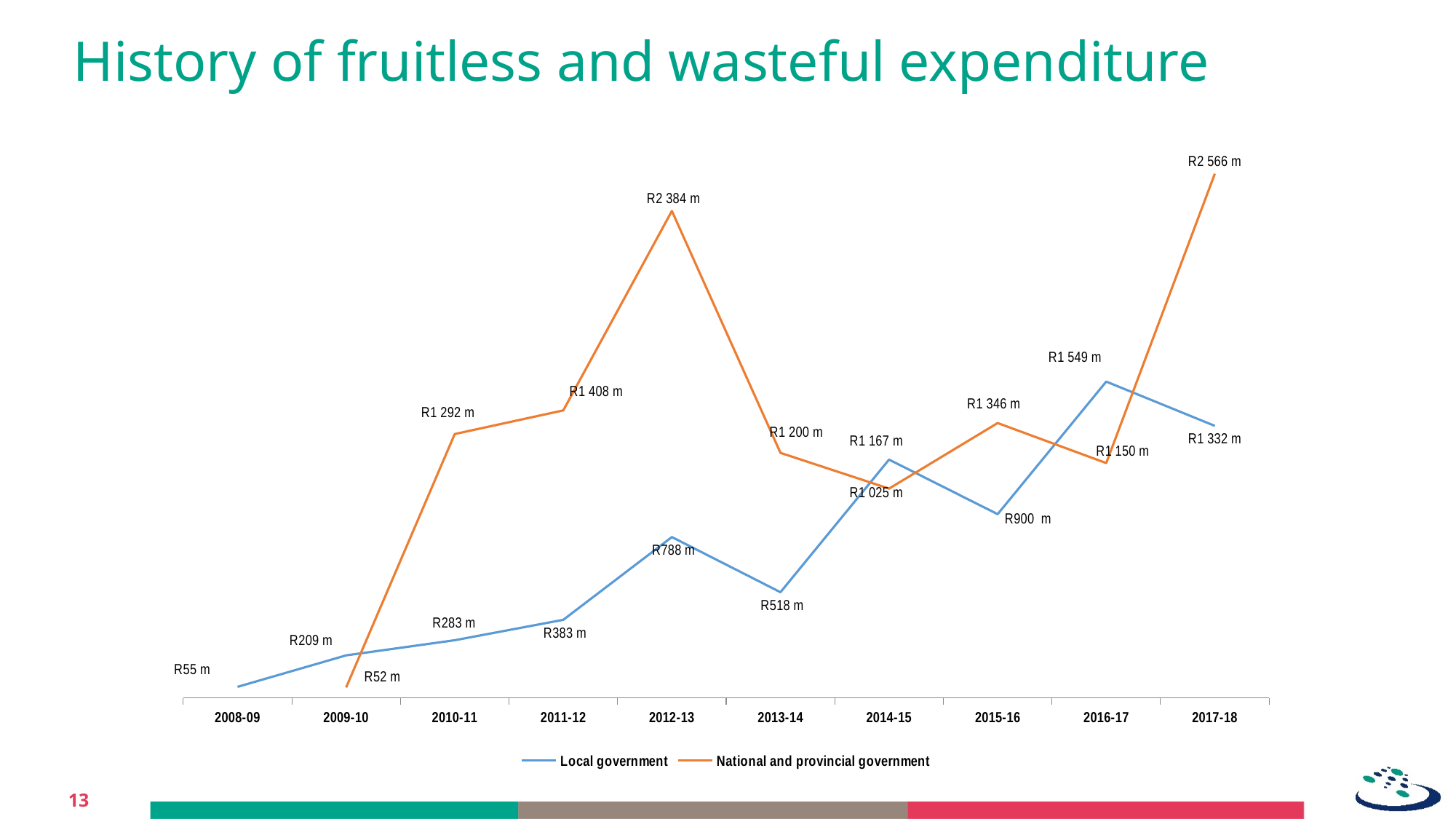
How many financial years are shown on the x axis? 10 In which year is the Local government value lowest? 2008-09 What is the value for Local government in 2012-13? R788 m Does the National and provincial government value rise or fall from 2012-13 to 2014-15? Fall How many series does the legend list? 2 What is the value for National and provincial government in 2017-18? R2 566 m In which year is the Local government value highest? 2016-17 What is the title of the slide? History of fruitless and wasteful expenditure In 2014-15, which series has the larger value, Local government or National and provincial government? Local government What kind of chart is shown on the slide? Line chart What is the difference between National and provincial government and Local government in 2017-18? R1 234 m In which year is the National and provincial government value highest? 2017-18